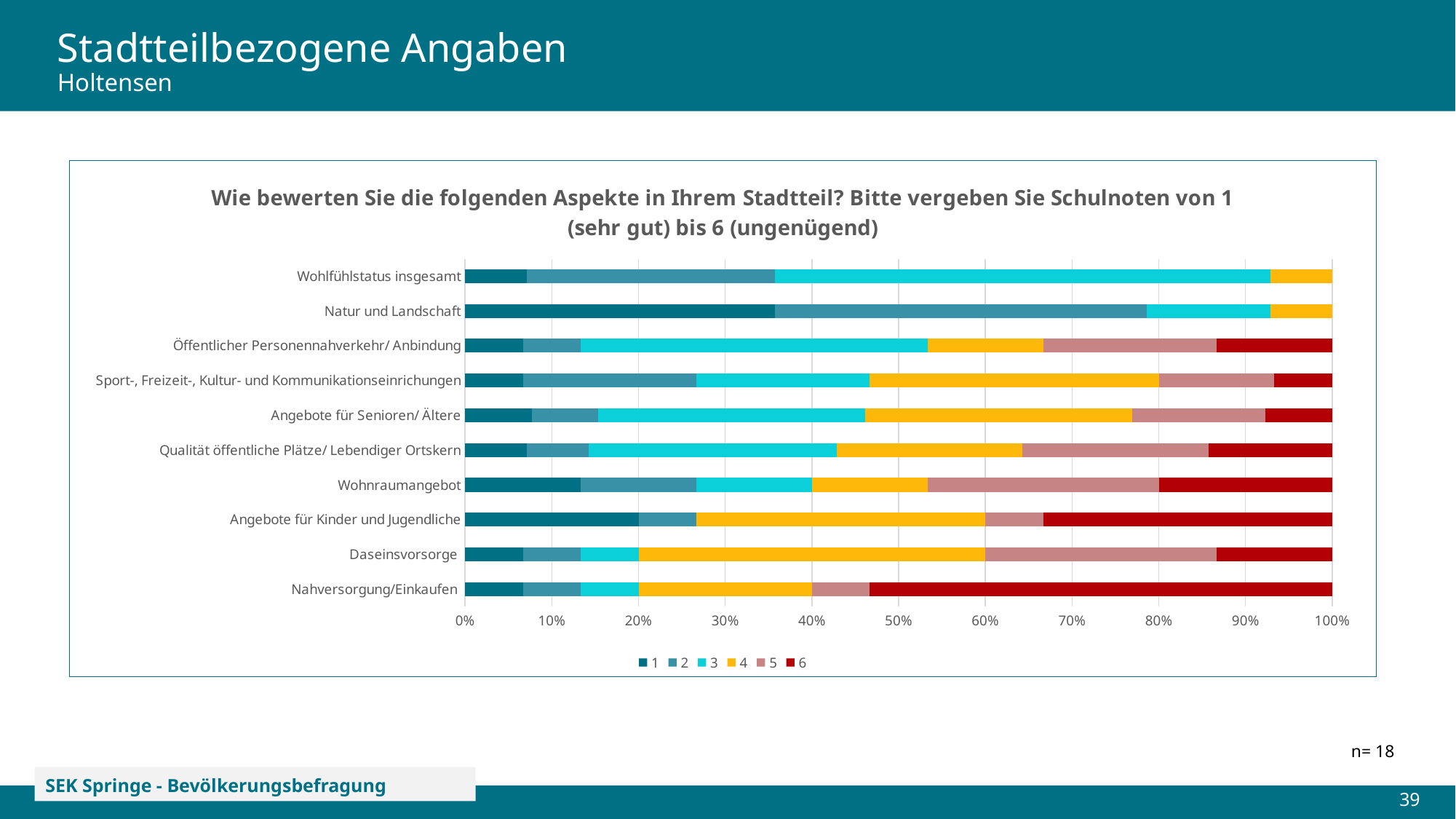
Is the share of grade 3 for Wohlfühlstatus insgesamt greater or less than 50%? greater What kind of chart is shown on the slide? Stacked bar chart Which category has the largest share of grade 1 (darkest teal segment)? Natur und Landschaft Which category has the largest share of grade 6 (dark red segment)? Nahversorgung/Einkaufen Which category has the larger share of grade 6: Nahversorgung/Einkaufen or Daseinsvorsorge? Nahversorgung/Einkaufen How many categories (aspects) are plotted on the y axis of the chart? 10 What is the highest value shown on the x axis of the chart? 100% Is the share of grade 1 for Natur und Landschaft greater or less than 30%? greater Is the share of grade 6 for Nahversorgung/Einkaufen greater or less than 50%? greater What are the legend entries of the chart? 1, 2, 3, 4, 5, 6 How many series does the legend of the chart list? 6 Which category has the larger share of grade 1: Natur und Landschaft or Wohlfühlstatus insgesamt? Natur und Landschaft